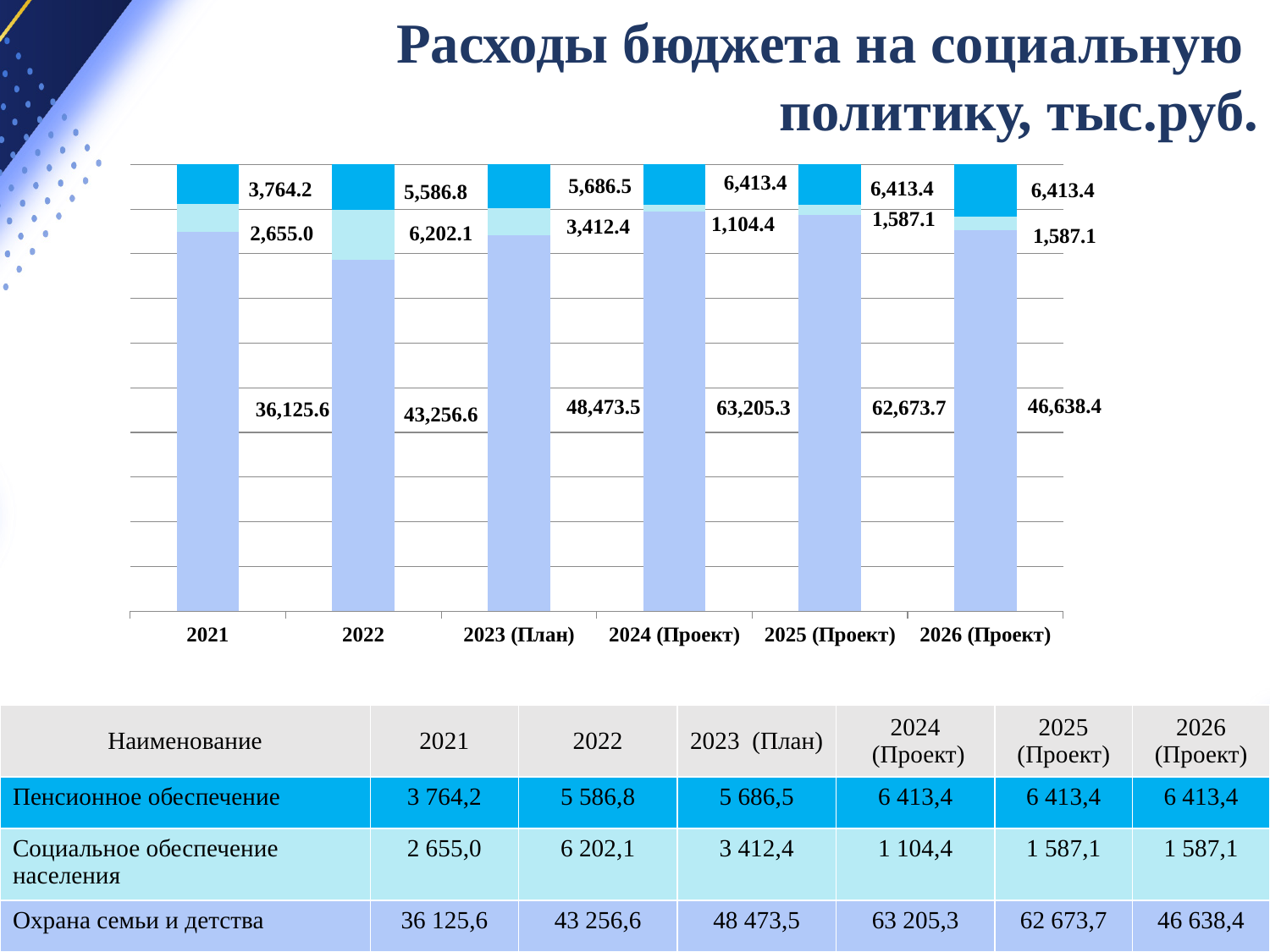
What is the value of the middle (cyan) segment, Социальное обеспечение населения, for 2022? 6,202.1 What is the total of the stacked bar for 2024 (Проект)? 70,723.1 In which year is the Социальное обеспечение населения segment the smallest? 2024 (Проект) What is the total of the stacked bar for 2021? 42,544.8 Does the Охрана семьи и детства value rise or fall from 2021 to 2024 (Проект)? Rise In which year is the Охрана семьи и детства segment the largest? 2024 (Проект) Which is larger: the Охрана семьи и детства value for 2025 (Проект) or for 2026 (Проект)? 2025 (Проект) What is the difference between the Охрана семьи и детства values for 2024 (Проект) and 2021? 27,079.7 How many years (categories) are shown on the x axis of the chart? 6 What kind of chart is shown on the slide? Stacked bar chart What is the value of the top (dark blue) segment, Пенсионное обеспечение, for 2021? 3,764.2 What is the value of the bottom (light blue) segment, Охрана семьи и детства, for 2024 (Проект)? 63,205.3